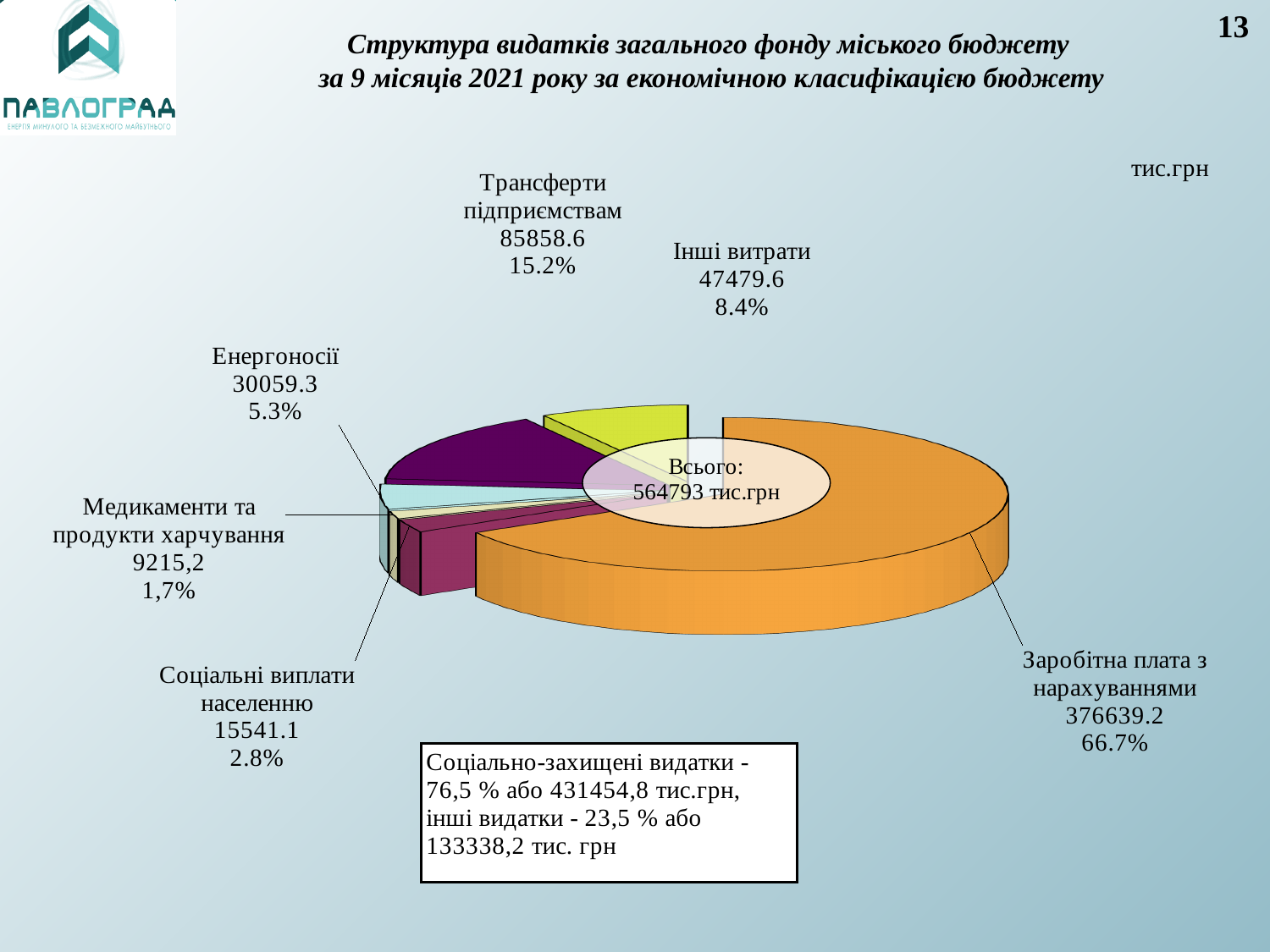
What is the value for Інші витрати? 47479.6 Which category has the largest slice of the pie? Заробітна плата з нарахуваннями Which category has the smallest slice of the pie? Медикаменти та продукти харчування Which is larger, Трансферти підприємствам or Інші витрати? Трансферти підприємствам What kind of chart is shown on the slide? pie chart What is the value for Соціальні виплати населенню? 15541.1 What share of the pie does Енергоносії represent? 5.3% How many categories are shown in the pie chart? 6 What is the difference between the values for Трансферти підприємствам and Інші витрати? 38379 What share of the pie does Трансферти підприємствам represent? 15.2% What is the value for Заробітна плата з нарахуваннями? 376639.2 What total is shown in the centre of the pie chart? 564793 тис.грн